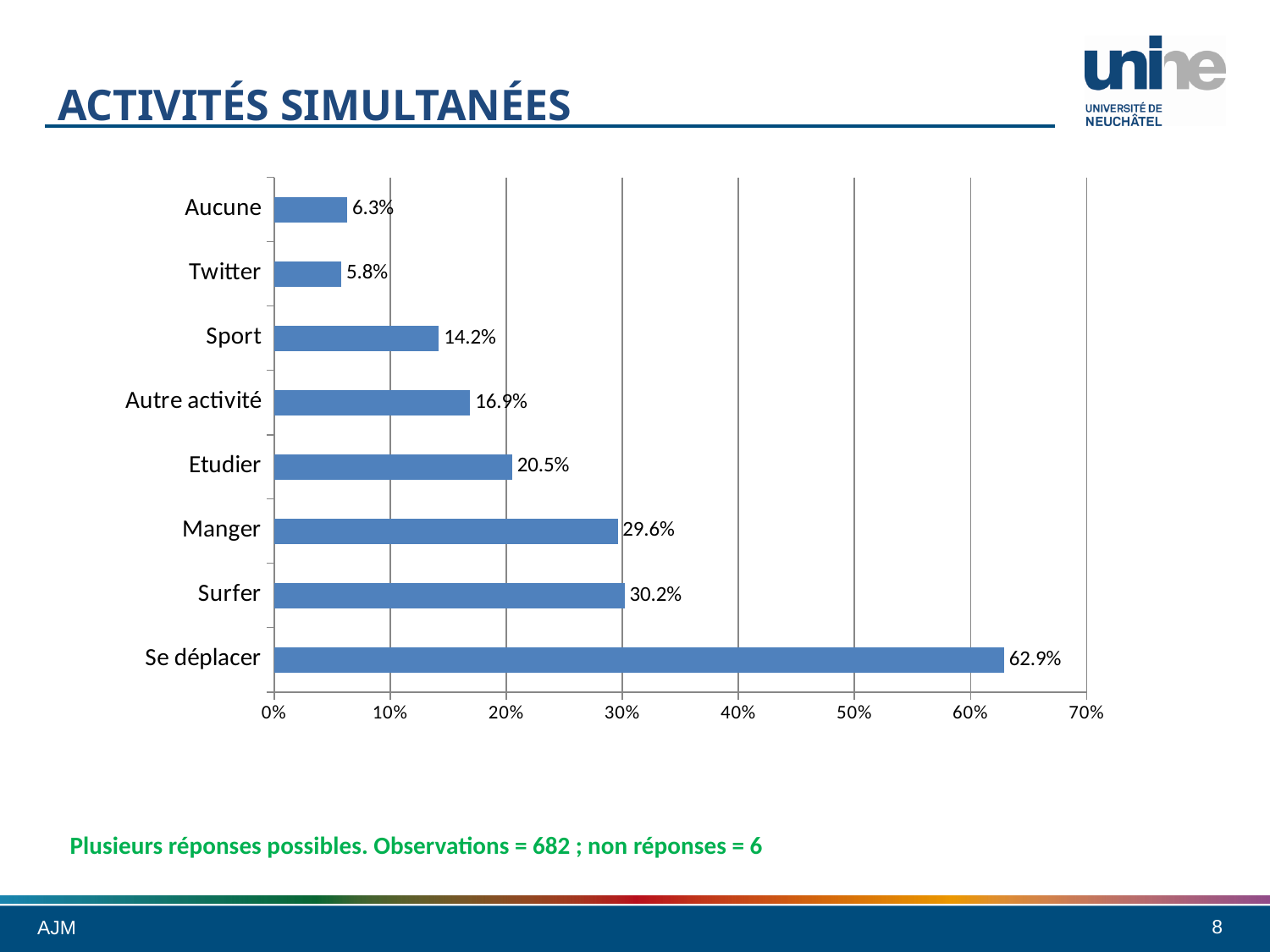
What is the value for Twitter? 5.8% How many categories are shown in the chart? 8 Is the value for Se déplacer greater or less than 60%? greater Which category has the lowest value? Twitter Which is larger, the value for Manger or the value for Etudier? Manger Which category has the highest value? Se déplacer What kind of chart is shown on the slide? Bar chart What is the difference between the values for Se déplacer and Surfer? 32.7% What is the title of the slide containing the chart? ACTIVITÉS SIMULTANÉES What is the value for Se déplacer? 62.9% What is the value for Etudier? 20.5% What is the difference between the values for Sport and Aucune? 7.9%